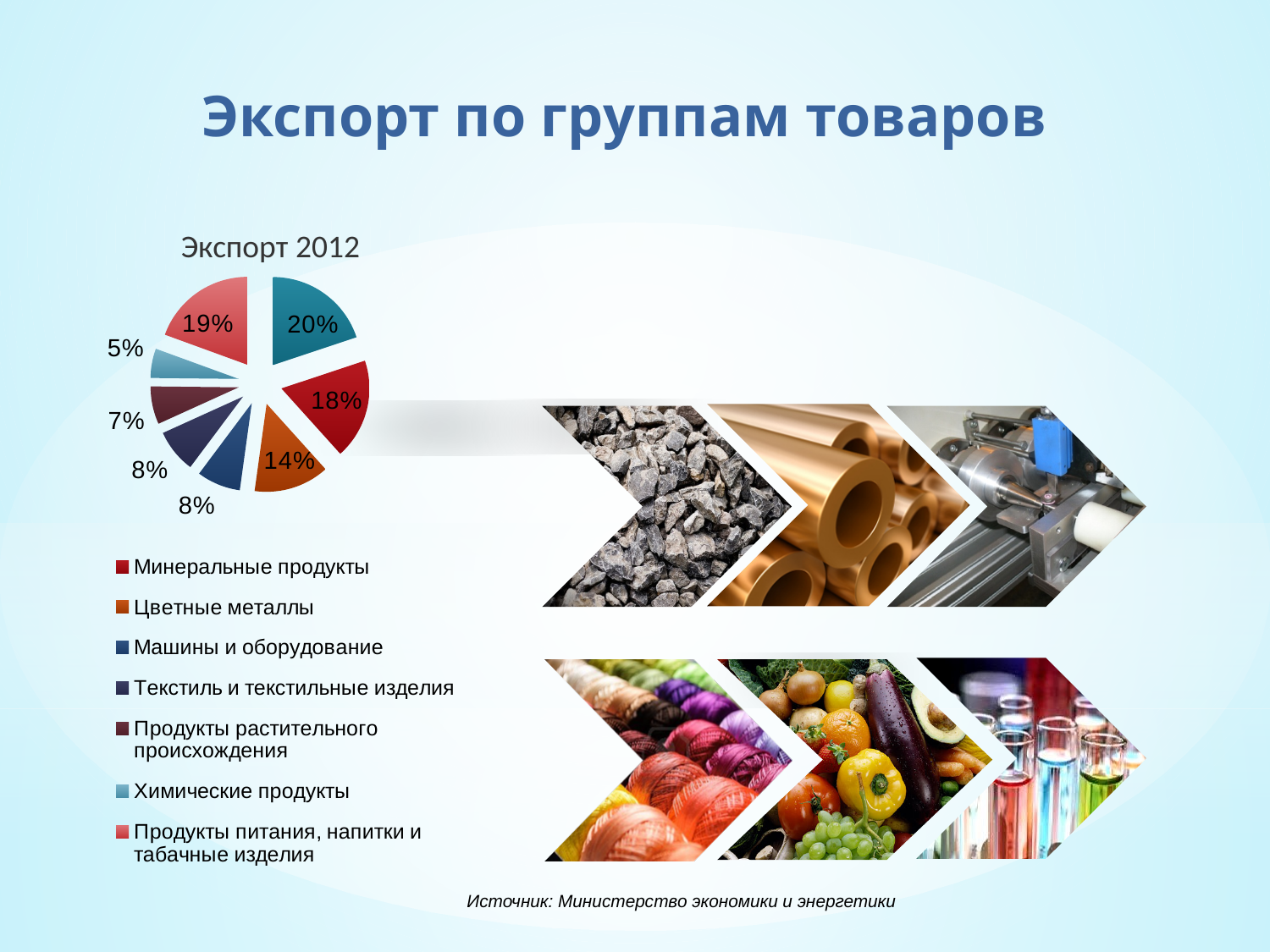
What share of exports in 2012 is Химические продукты? 5% What is the title of the pie chart? Экспорт 2012 How many percentage points larger is the share of Минеральные продукты than Цветные металлы? 4 How many slices does the pie chart have? 8 What share of exports in 2012 is Продукты питания, напитки и табачные изделия? 19% What kind of chart is shown on the slide? pie chart Which has a larger share of exports in 2012: Цветные металлы or Машины и оборудование? Цветные металлы Which legend category has the largest share of exports in 2012? Продукты питания, напитки и табачные изделия Which legend category has the smallest share of exports in 2012? Химические продукты What share of exports in 2012 is Продукты растительного происхождения? 7% What share of exports in 2012 is Цветные металлы? 14% What share of exports in 2012 is Минеральные продукты? 18%